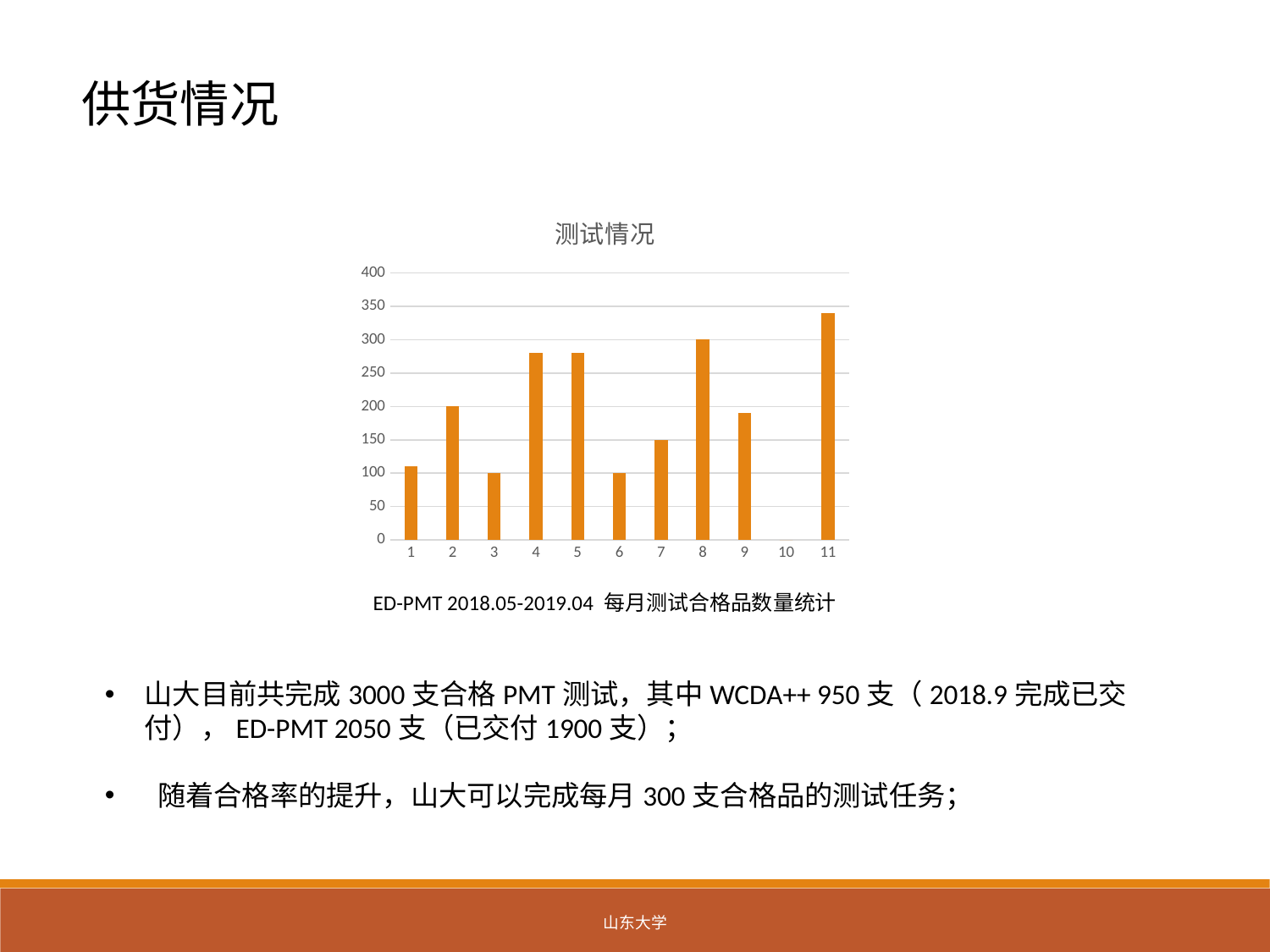
Is the value for category 9 greater or less than 200? less Is the value for category 11 greater or less than 300? greater Which is larger, the value for category 8 or the value for category 9? category 8 What is the value for category 7? 150 Is the value for category 4 greater or less than 250? greater What is the value for category 8? 300 Which category has the highest bar in the chart? 11 What is the title of the chart? 测试情况 What is the difference between the values for category 8 and category 7? 150 What is the value for category 2? 200 How many categories are shown on the x axis of the chart? 11 What type of chart is shown on the slide? bar chart